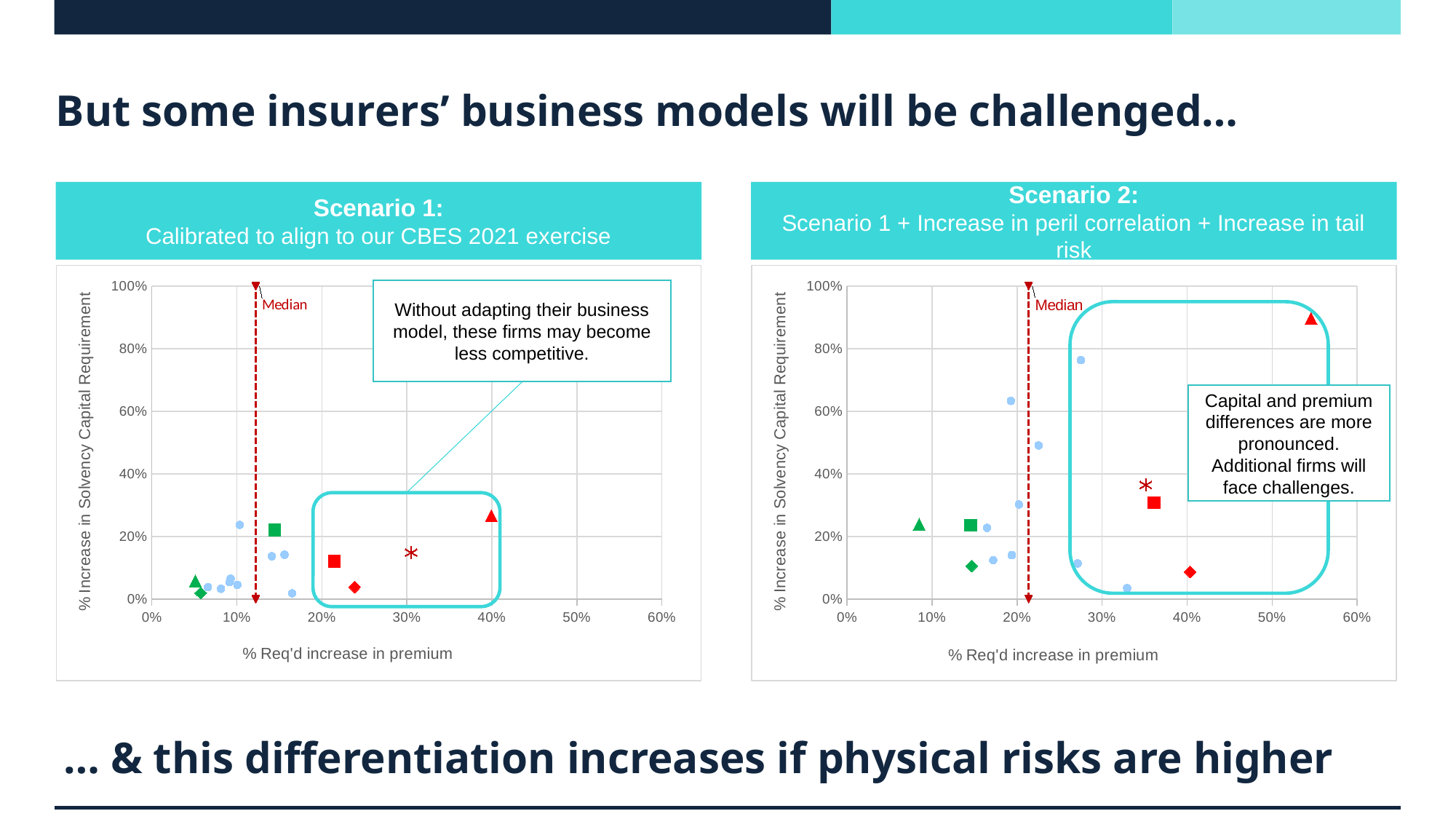
In the Scenario 1 chart, is the median % required increase in premium greater or less than 20%? less What kind of chart is the Scenario 1 chart? Scatter chart What is the x-axis title of the Scenario 1 chart? % Req'd increase in premium In the Scenario 1 chart, what does the dashed red vertical line represent? Median Which chart shows the red triangle at a higher % increase in Solvency Capital Requirement, Scenario 1 or Scenario 2? Scenario 2 In the Scenario 2 chart, is the y value of the red triangle greater or less than 80%? greater How many charts are shown on the slide? 2 In the Scenario 1 chart, is the y value of the green square greater or less than 40%? less